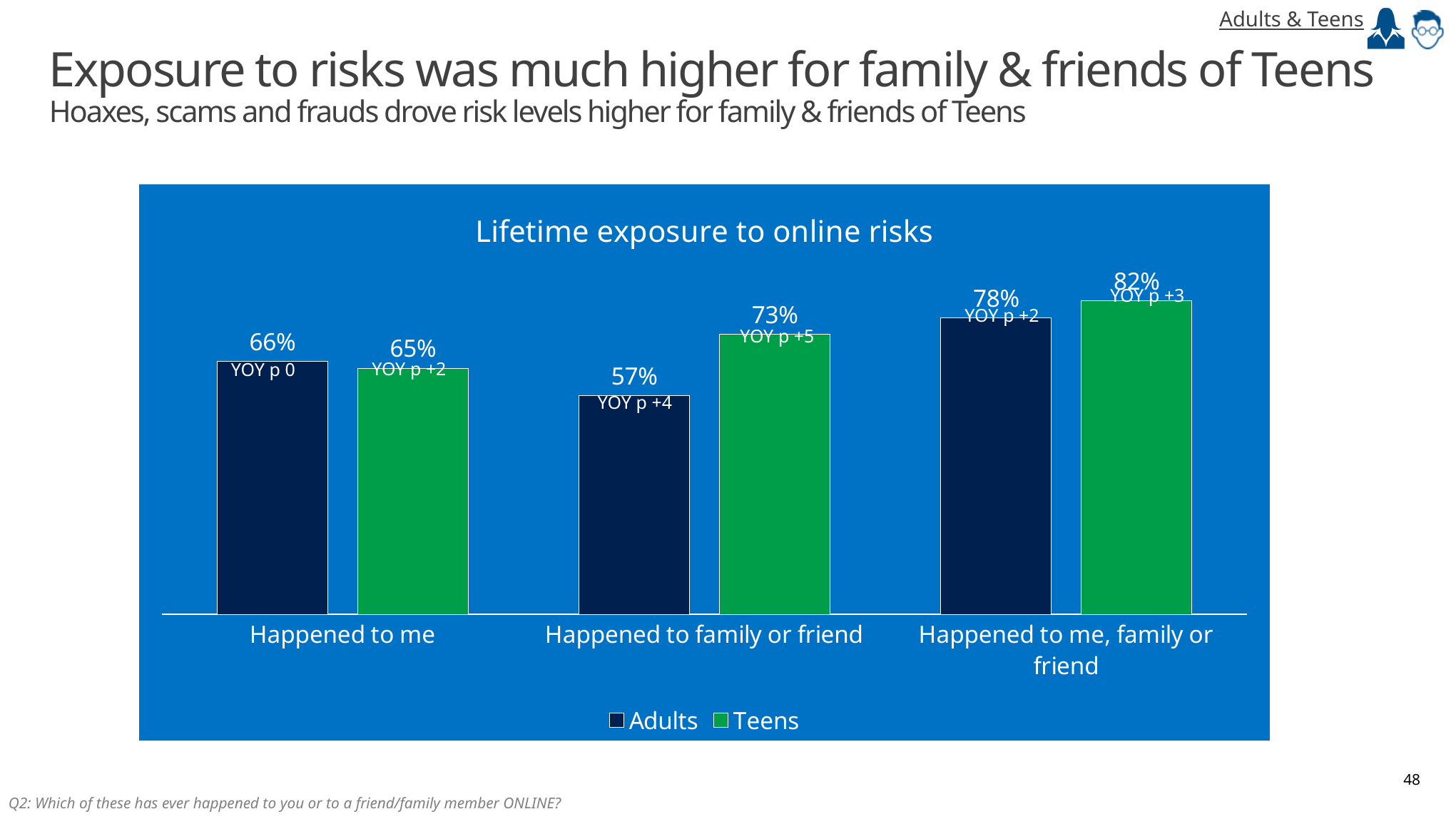
What is the value for Teens in the 'Happened to me, family or friend' category? 82% What is the value for Adults in the 'Happened to family or friend' category? 57% What is the value for Adults in the 'Happened to me' category? 66% How many categories are shown on the x axis? 3 What is the difference between the Teens and Adults values in the 'Happened to family or friend' category? 16 percentage points In the 'Happened to me, family or friend' category, which series has the larger value, Adults or Teens? Teens Which category has the lowest value for Adults? Happened to family or friend What kind of chart is shown on the slide? Bar chart Which category has the highest value for Teens? Happened to me, family or friend What is the title of the chart? Lifetime exposure to online risks What is the value for Teens in the 'Happened to family or friend' category? 73% How many series does the legend list? 2